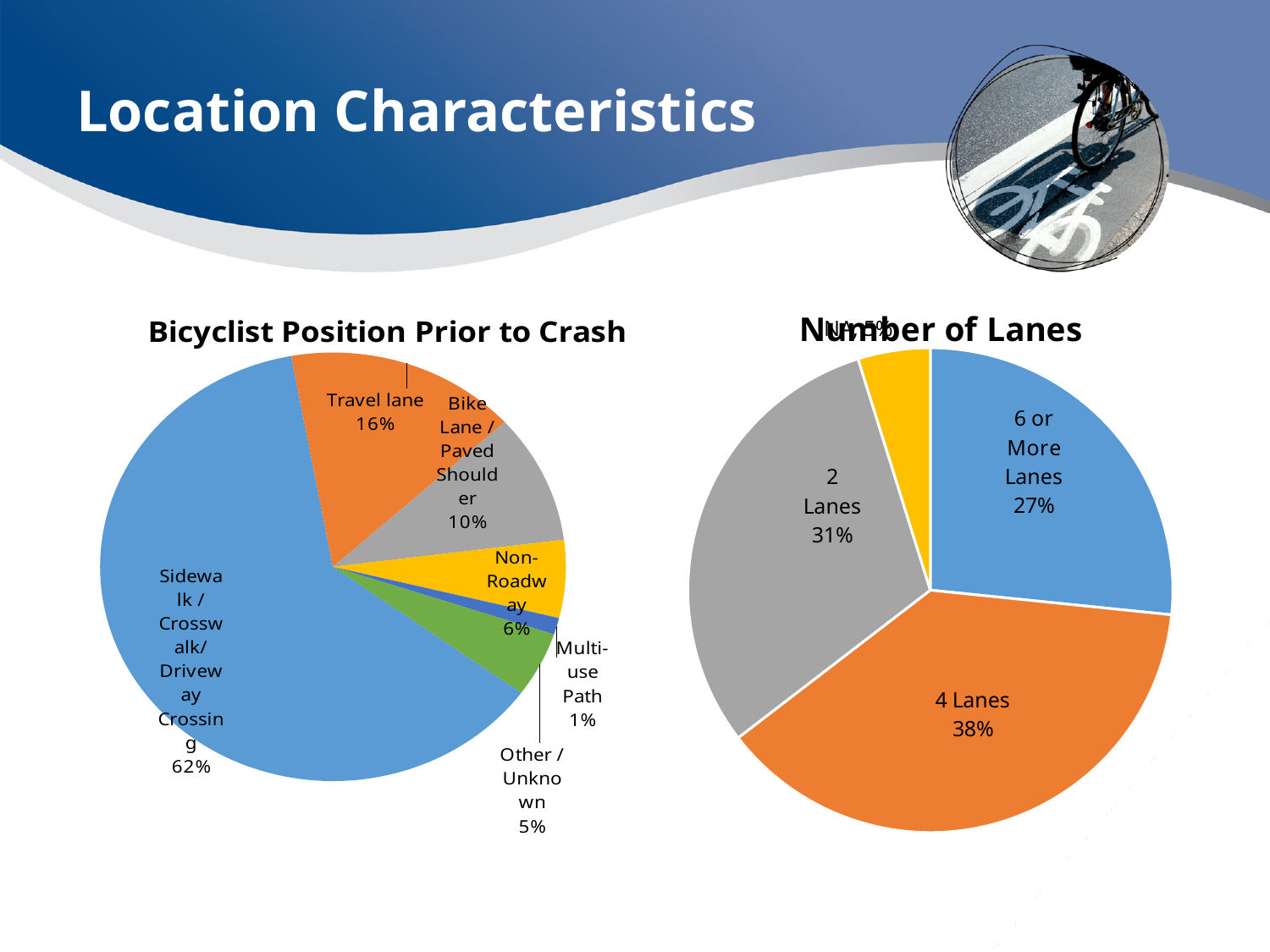
On the Bicyclist Position Prior to Crash chart, how many percentage points larger is Non-Roadway than Other / Unknown? 1 What type of chart is used for Number of Lanes? Pie chart On the Bicyclist Position Prior to Crash chart, what percentage is shown for Bike Lane / Paved Shoulder? 10% On the Bicyclist Position Prior to Crash chart, what share of crashes had the bicyclist on a Sidewalk / Crosswalk / Driveway Crossing? 62% On the Bicyclist Position Prior to Crash chart, how many slices does the pie have? 6 On the Number of Lanes chart, how many percentage points larger is 4 Lanes than 6 or More Lanes? 11 On the Number of Lanes chart, what percentage is shown for 2 Lanes? 31% On the Number of Lanes chart, what percentage is shown for 4 Lanes? 38% On the Bicyclist Position Prior to Crash chart, which category has the smallest slice? Multi-use Path On the Number of Lanes chart, which labelled category has the largest slice? 4 Lanes On the Bicyclist Position Prior to Crash chart, which is larger, Travel lane or Bike Lane / Paved Shoulder? Travel lane On the Bicyclist Position Prior to Crash chart, what percentage is shown for Travel lane? 16%